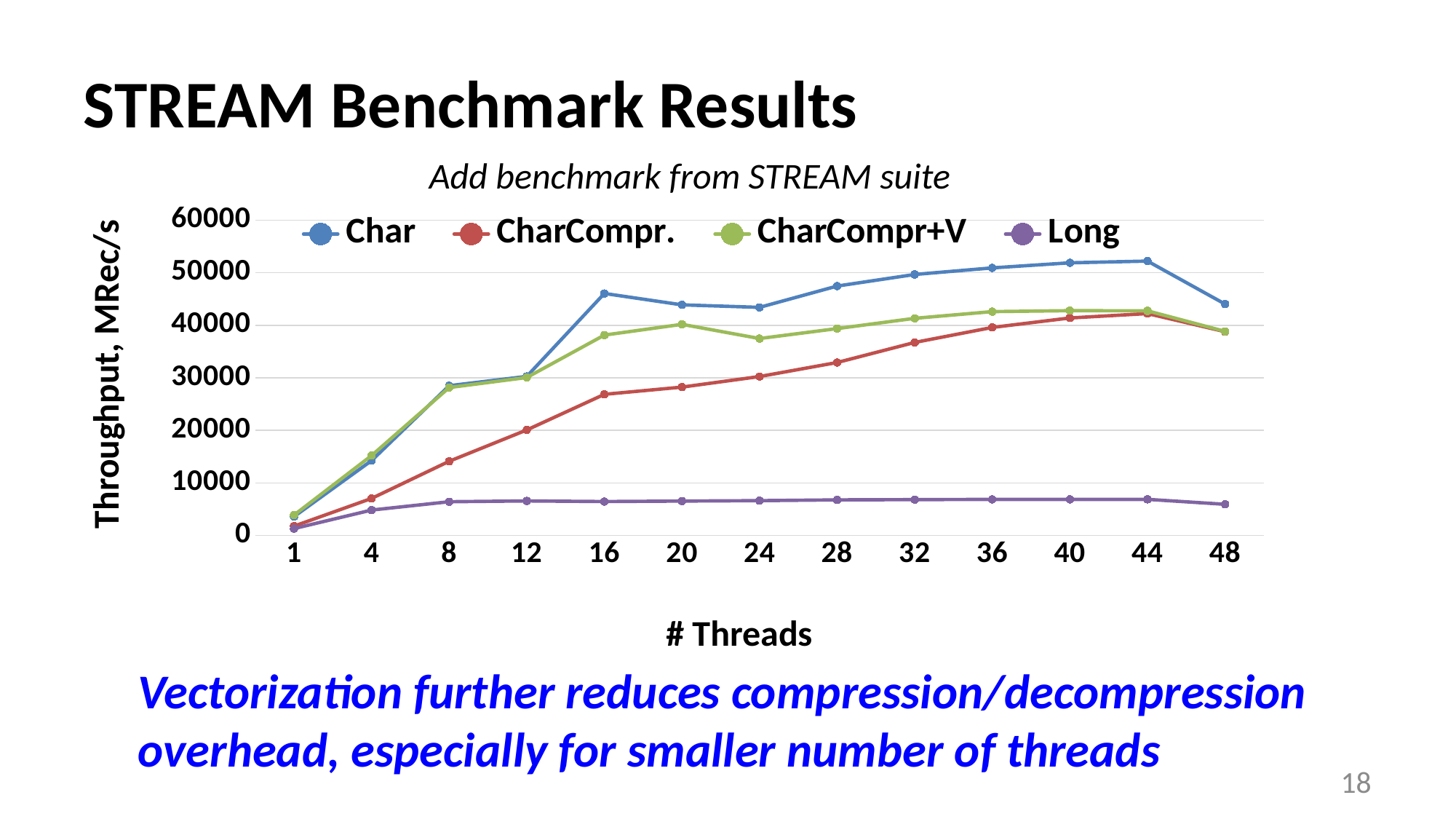
Is the Long throughput at 48 threads greater or less than 10000? less At 24 threads, which has the higher throughput: Char or CharCompr+V? Char Which series has the lowest throughput at 40 threads? Long What kind of chart is shown on the slide? line chart What is the label of the y axis? Throughput, MRec/s How many series does the legend list? 4 Which series has the highest throughput at 44 threads? Char How many thread counts are plotted along the x axis? 13 Does the Char throughput generally rise or fall from 1 to 44 threads? rise Is the Char throughput at 16 threads greater or less than 40000? greater Is the CharCompr. throughput at 8 threads greater or less than 10000? greater